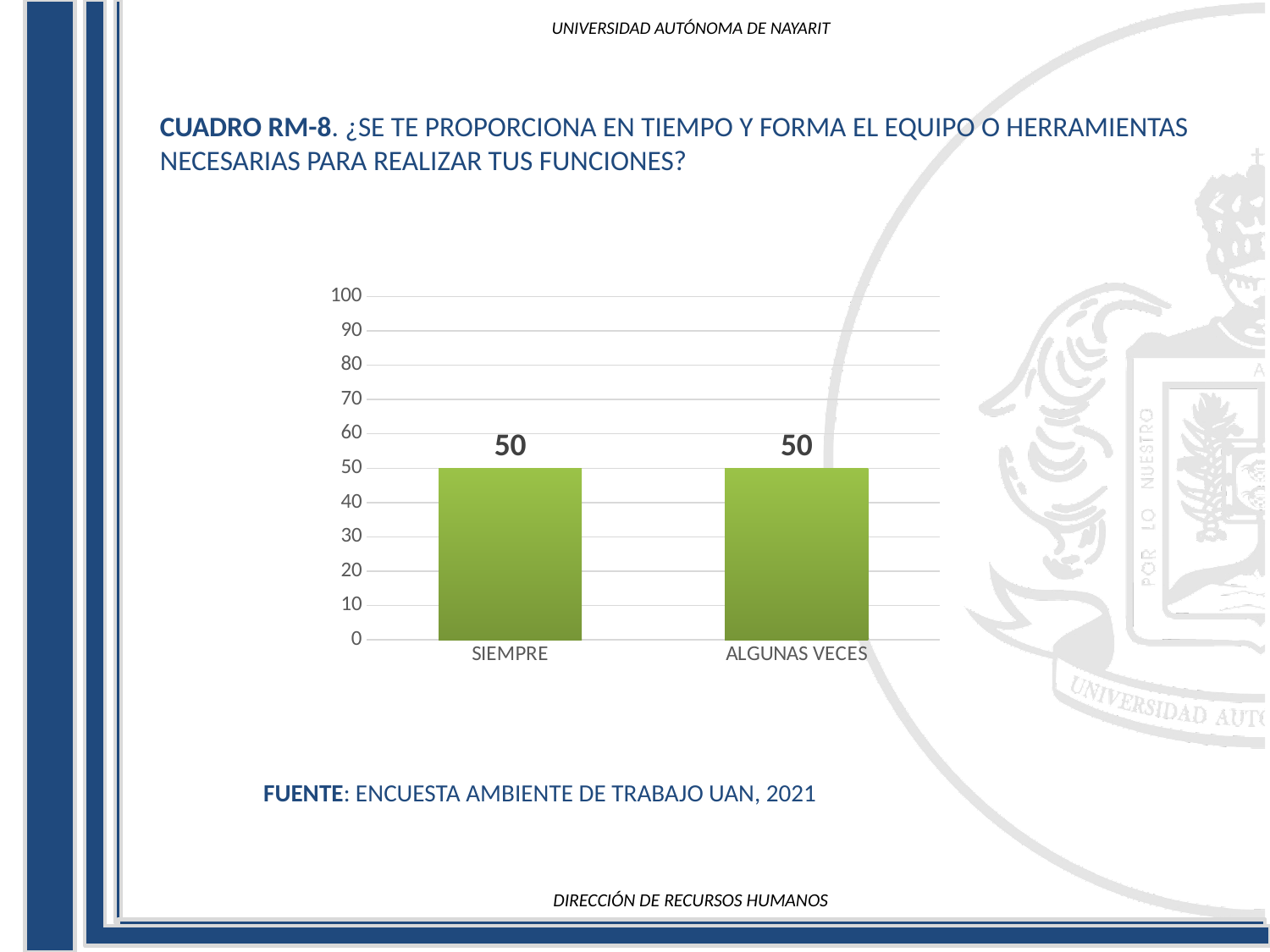
What is the value for SIEMPRE? 50 What is the difference between the values for SIEMPRE and ALGUNAS VECES? 0 What is the value for ALGUNAS VECES? 50 What kind of chart is shown on the slide? bar chart Is the value for SIEMPRE greater or less than 70? less What is the source cited below the chart? ENCUESTA AMBIENTE DE TRABAJO UAN, 2021 How many categories are shown on the x axis? 2 Do the values rise, fall or stay the same from SIEMPRE to ALGUNAS VECES? stay the same What is the highest value shown on the vertical axis? 100 Is the value for ALGUNAS VECES greater or less than 30? greater